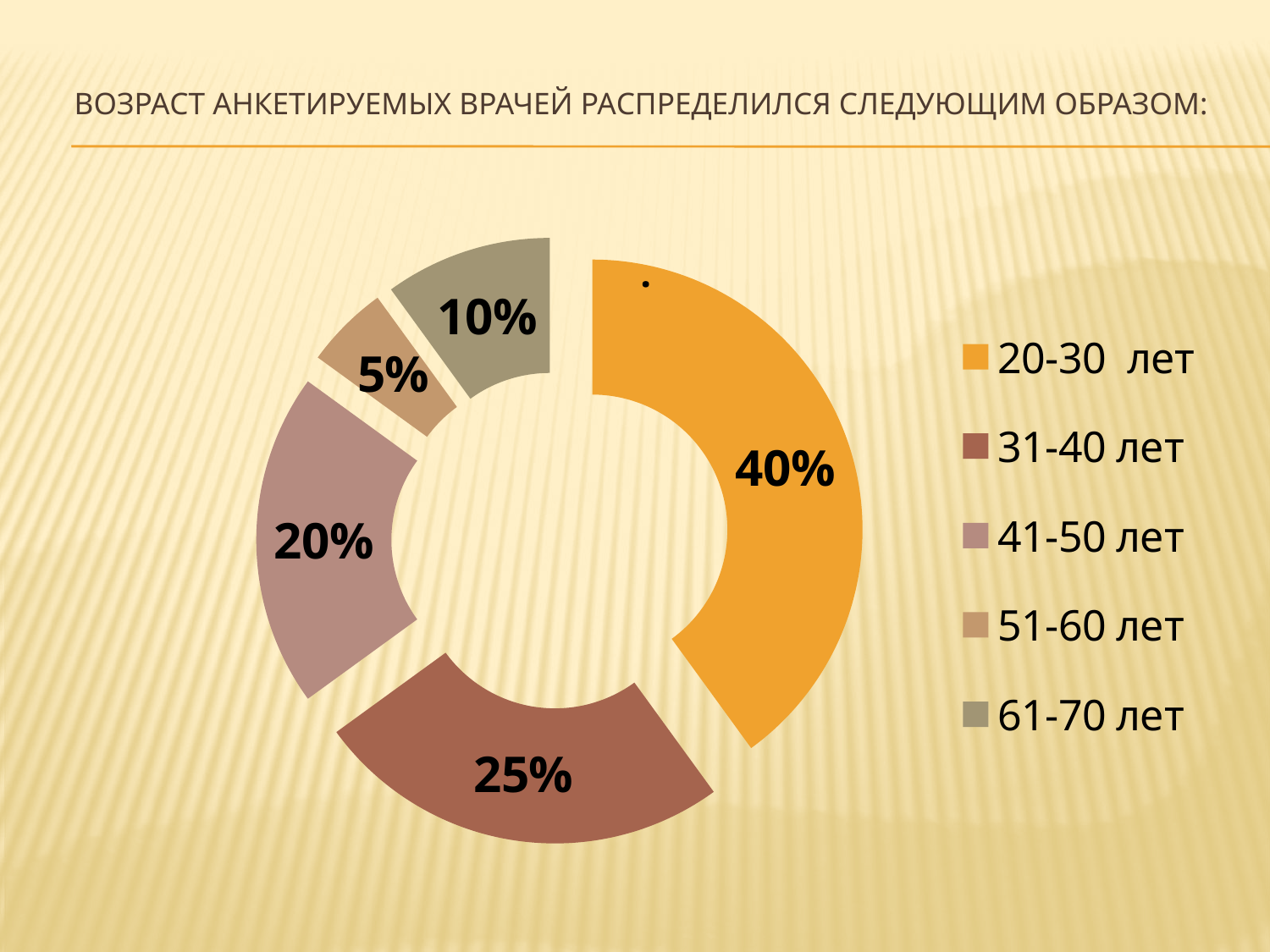
What share of the surveyed doctors are aged 20-30 лет? 40% What share of the surveyed doctors are aged 31-40 лет? 25% Which age group has the smallest share of surveyed doctors? 51-60 лет What share of the surveyed doctors are aged 61-70 лет? 10% How many age groups are shown in the chart? 5 What colour is the slice for the 20-30 лет group? Orange What is the difference in percentage points between the 20-30 лет and 31-40 лет groups? 15% Which age group has the largest share of surveyed doctors? 20-30 лет What share of the surveyed doctors are aged 51-60 лет? 5% What share of the surveyed doctors are aged 41-50 лет? 20% What type of chart is shown on the slide? Doughnut (pie) chart Which group has a larger share: 41-50 лет or 61-70 лет? 41-50 лет